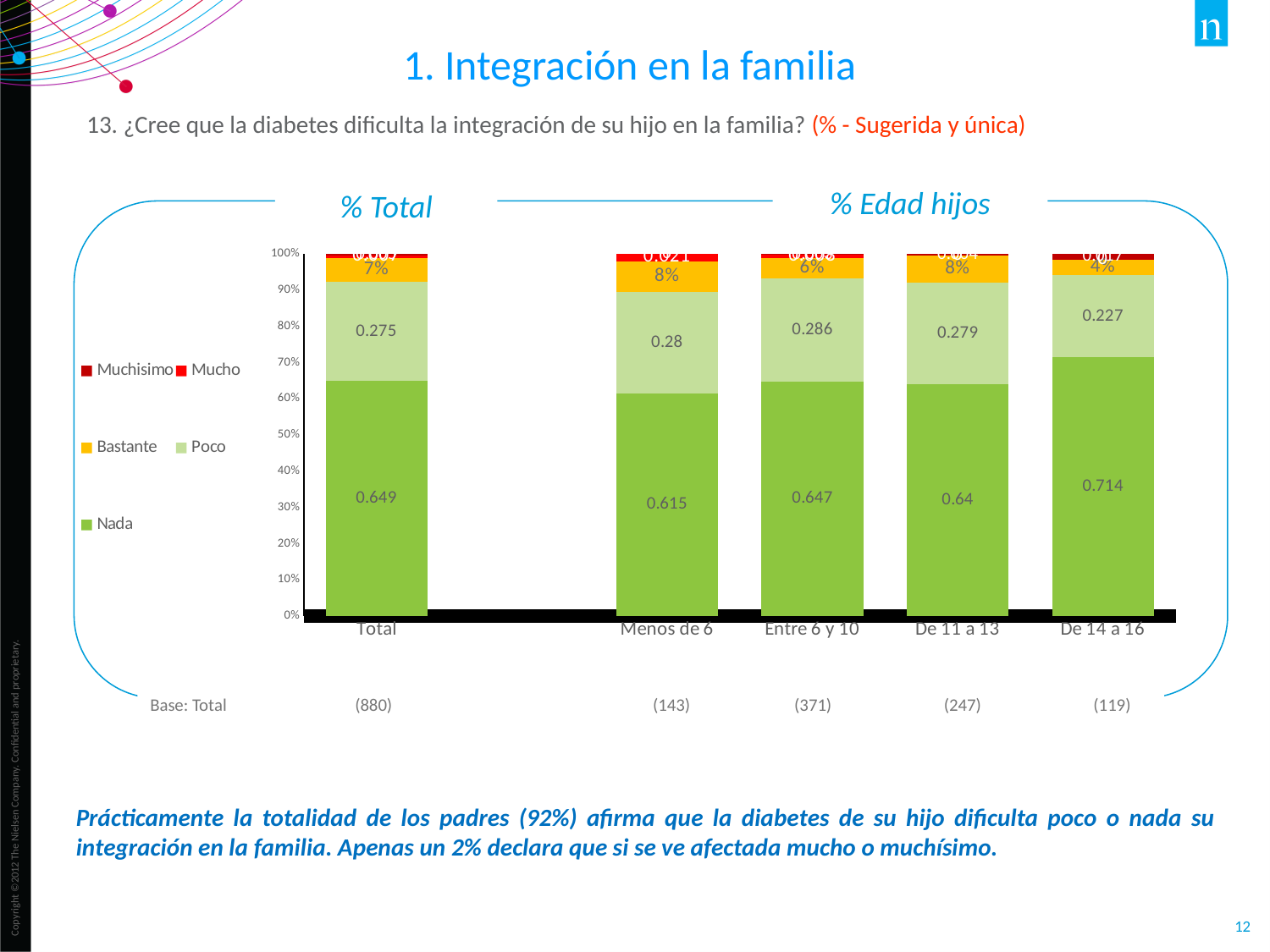
What is the value of the Nada segment for De 14 a 16? 0.714 What is the value of the Poco segment for Entre 6 y 10? 0.286 What is the value of the Bastante segment for Menos de 6? 8% What kind of chart is shown on the slide? Stacked bar chart How many categories are shown on the x axis of the chart? 5 Which category has the lowest Poco value? De 14 a 16 What is the value of the Bastante segment for De 14 a 16? 4% Which category has the highest Nada value? De 14 a 16 How many series does the legend list? 5 What is the value of the Nada segment for the Total bar? 0.649 Which category has the lowest Nada value? Menos de 6 Which is larger, the Nada value for Total or the Nada value for Menos de 6? Total